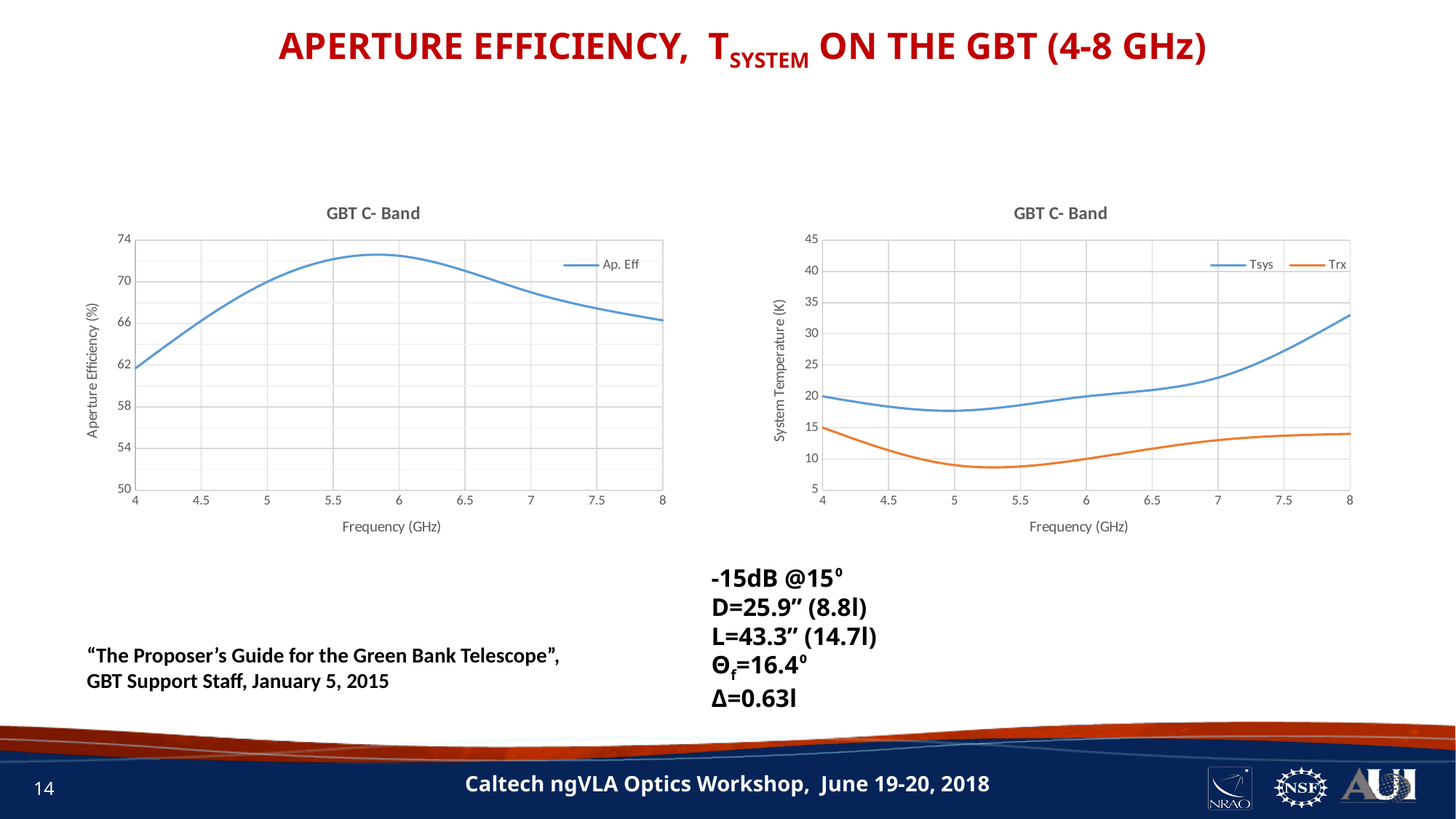
In the right chart, does Tsys rise or fall between 6 GHz and 8 GHz? rise In the left chart, does the aperture efficiency rise or fall between 6 GHz and 8 GHz? fall What is the title of the left chart? GBT C- Band In the right chart, is the Trx value at 5.5 GHz greater or less than 10? less In the right chart, is the Tsys value at 8 GHz greater or less than 30? greater In the left chart, is the aperture efficiency at 5.5 GHz greater or less than 70? greater In the right chart, which series has the larger value at 8 GHz, Tsys or Trx? Tsys How many series does the legend of the right chart (System Temperature) list? 2 In the left chart, does the aperture efficiency rise or fall between 4 GHz and 5.5 GHz? rise What kind of chart is the left chart (Aperture Efficiency)? line chart What are the legend entries of the right chart (System Temperature)? Tsys, Trx